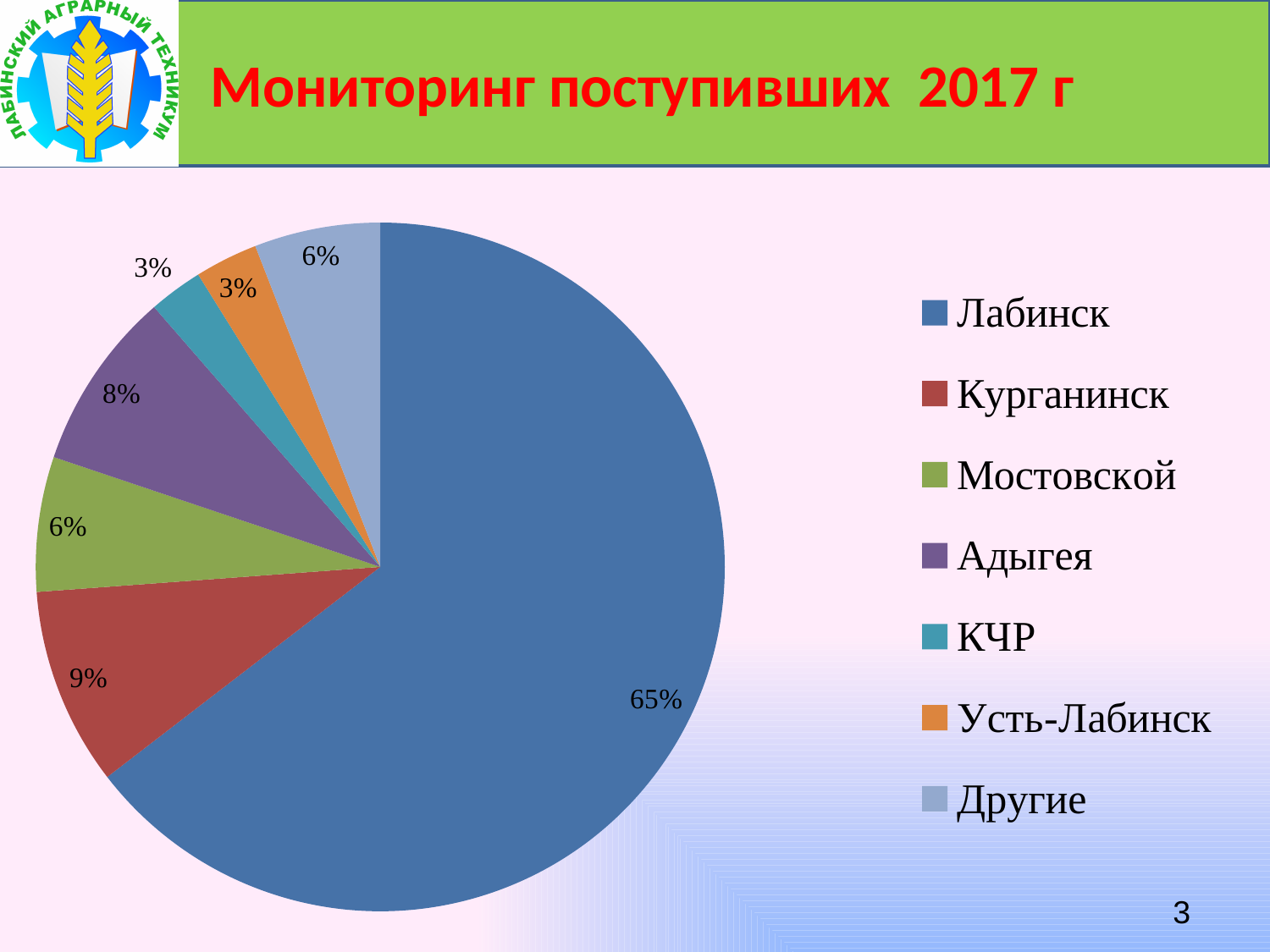
Which is larger, the share of Адыгея or the share of Мостовской? Адыгея What share of the pie does Адыгея have? 8% What is the difference between the shares of Лабинск and Курганинск? 56% How many categories does the legend list? 7 What is the title of the slide containing the chart? Мониторинг поступивших 2017 г What share of the pie does Курганинск have? 9% What share of the pie does Мостовской have? 6% What colour is the slice for Усть-Лабинск? orange What kind of chart is shown on the slide? pie chart Which category has the largest slice of the pie? Лабинск